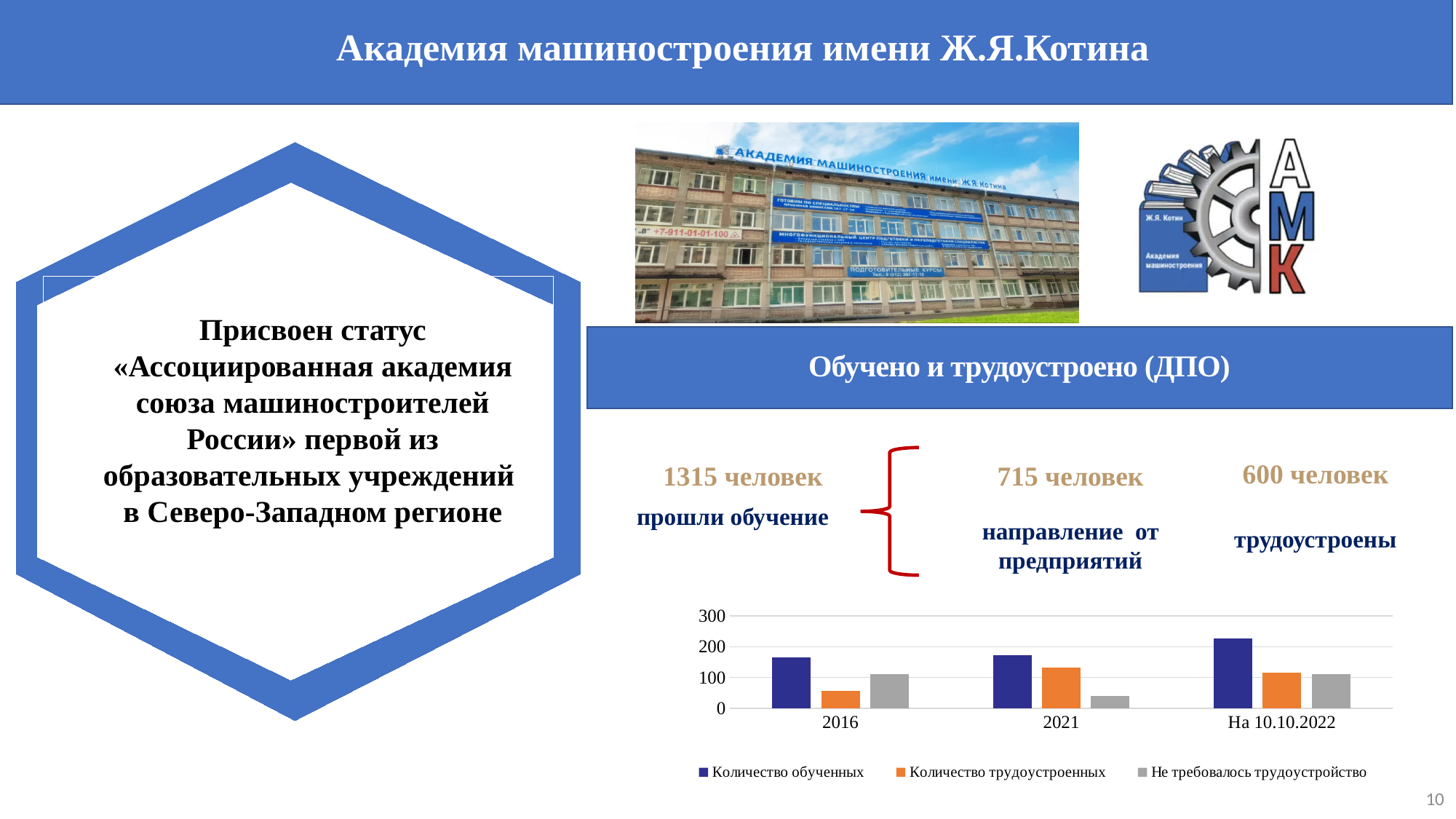
Is the value for Не требовалось трудоустройство in 2021 greater or less than 100? less In which category is the value for Не требовалось трудоустройство the lowest? 2021 Does the value for Количество обученных rise or fall from 2016 to На 10.10.2022? rise How many categories are shown on the x axis of the chart? 3 Which series in the chart is shown in orange? Количество трудоустроенных Is the value for Количество трудоустроенных in 2016 greater or less than 100? less How many series does the chart legend list? 3 In which category is the value for Количество обученных the highest? На 10.10.2022 What kind of chart is shown on the slide? bar chart In which category is the value for Количество трудоустроенных the lowest? 2016 Is the value for Количество обученных in На 10.10.2022 greater or less than 200? greater Which is larger: Количество трудоустроенных in 2021 or Количество трудоустроенных in 2016? 2021